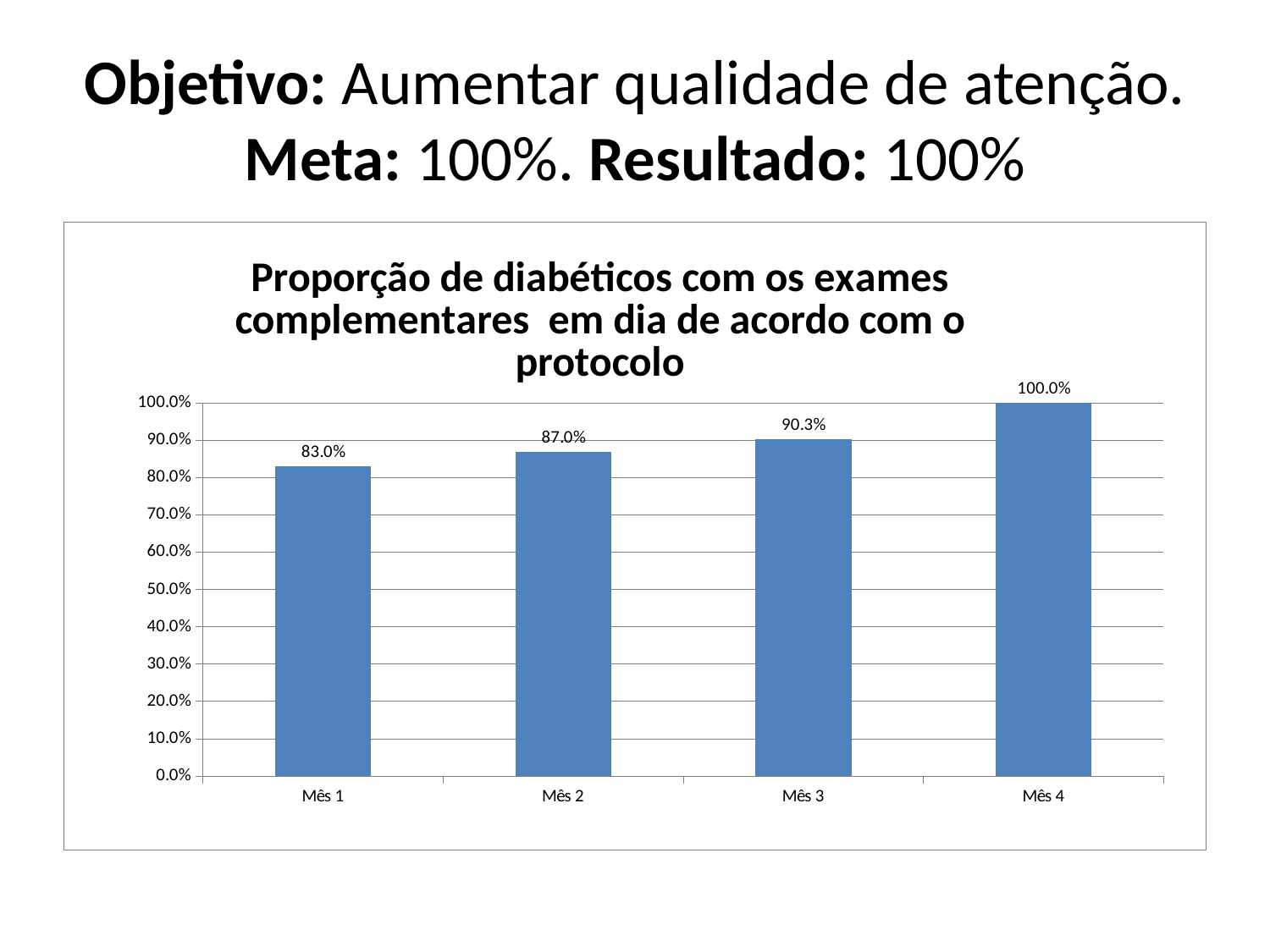
What is the difference between the values for Mês 4 and Mês 1? 17.0% Is the value for Mês 2 greater or less than 80.0%? greater What is the difference between the values for Mês 3 and Mês 2? 3.3% Which is larger, the value for Mês 2 or the value for Mês 3? Mês 3 What is the value for Mês 3? 90.3% Which month has the highest value? Mês 4 What is the value for Mês 4? 100.0% What is the value for Mês 1? 83.0% What kind of chart is shown on the slide? bar chart Do the values rise or fall from Mês 1 to Mês 4? rise Which month has the lowest value? Mês 1 How many months are shown on the x axis? 4